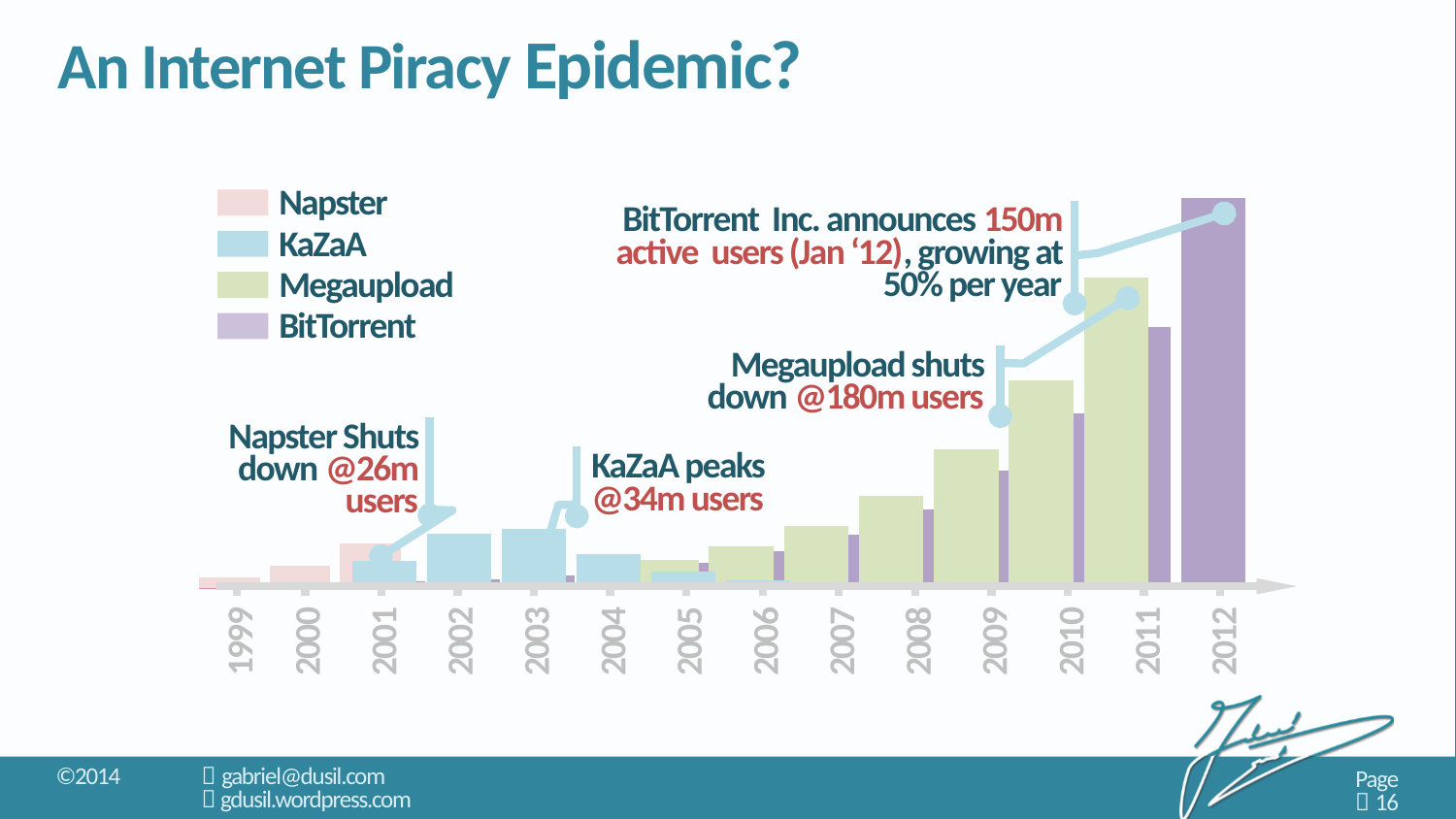
According to the annotation, how many users did Napster have when it shut down? 26m users How many years are shown along the x axis? 14 Do the BitTorrent bars rise or fall from 2006 to 2012? rise Which series has the tallest bar in 2012? BitTorrent Which series are listed in the legend? Napster, KaZaA, Megaupload, BitTorrent How many active users did BitTorrent Inc. announce in Jan '12? 150m What is the first year shown on the x axis? 1999 How many series does the legend list? 4 In 2010, which bar is taller: Megaupload or BitTorrent? Megaupload According to the annotation, how many users did Megaupload have when it shut down? 180m users What kind of chart is shown on the slide? bar chart According to the annotation, at how many users did KaZaA peak? 34m users